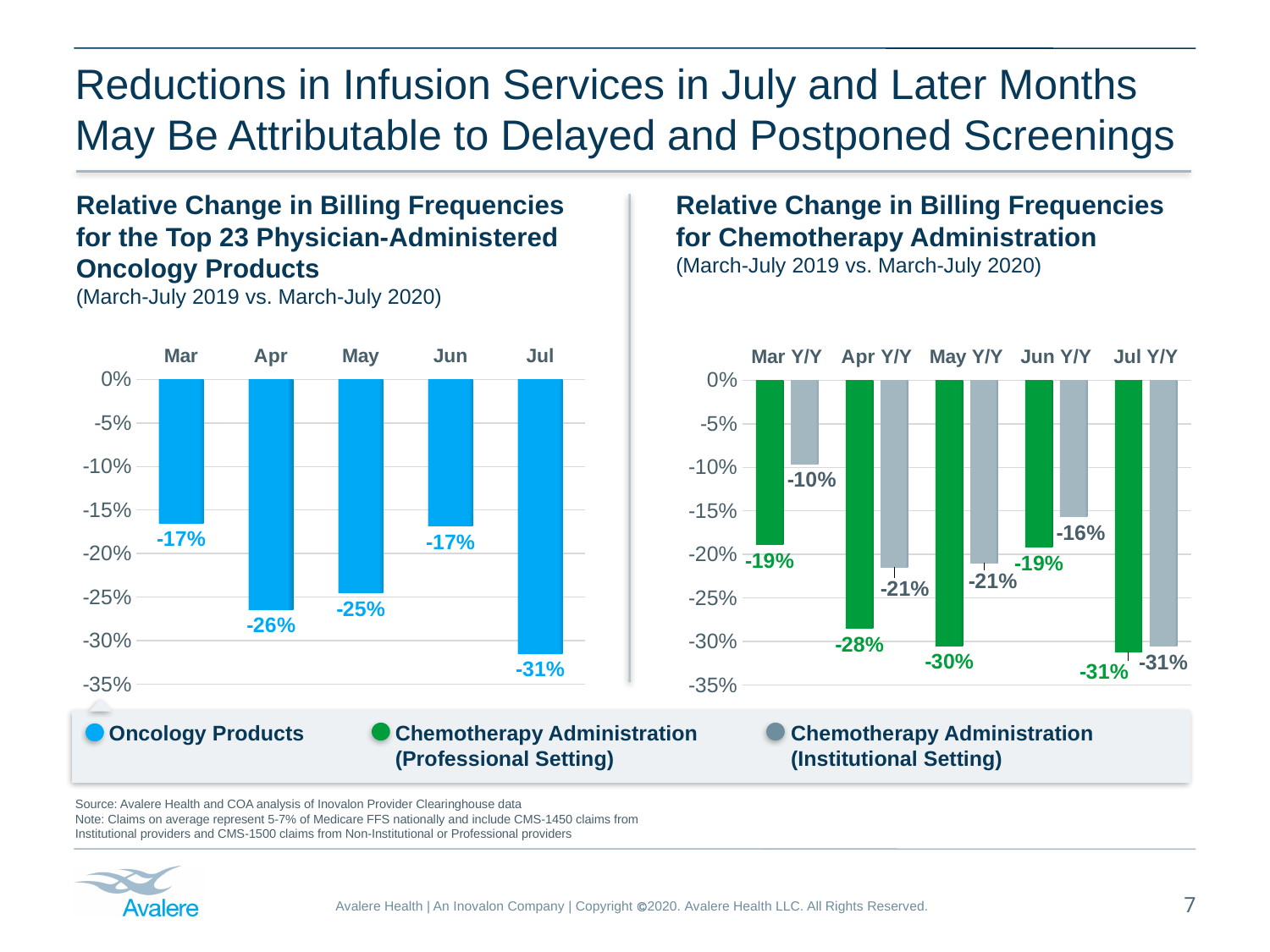
In the left chart (Top 23 Physician-Administered Oncology Products), what is the relative change for Apr? -26% In the left chart (Top 23 Physician-Administered Oncology Products), what is the difference between the Apr and May values? 1 percentage point In the right chart (Chemotherapy Administration), what is the Mar Y/Y value for the Institutional Setting? -10% In the left chart (Top 23 Physician-Administered Oncology Products), which month shows the largest reduction? Jul In the right chart (Chemotherapy Administration), which month shows the smallest reduction for the Institutional Setting? Mar Y/Y What type of chart is used on the left for the Top 23 Physician-Administered Oncology Products? Bar chart In the left chart (Top 23 Physician-Administered Oncology Products), how many months are plotted? 5 In the right chart (Chemotherapy Administration), what is the May Y/Y value for the Professional Setting? -30% How many series does the legend list for the right chart (Chemotherapy Administration)? 2 In the right chart (Chemotherapy Administration), what is the difference between the Professional and Institutional values for Jun Y/Y? 3 percentage points In the left chart (Top 23 Physician-Administered Oncology Products), what is the relative change for Jul? -31% In the right chart (Chemotherapy Administration), which has the larger reduction in Apr Y/Y: the Professional Setting or the Institutional Setting? Professional Setting